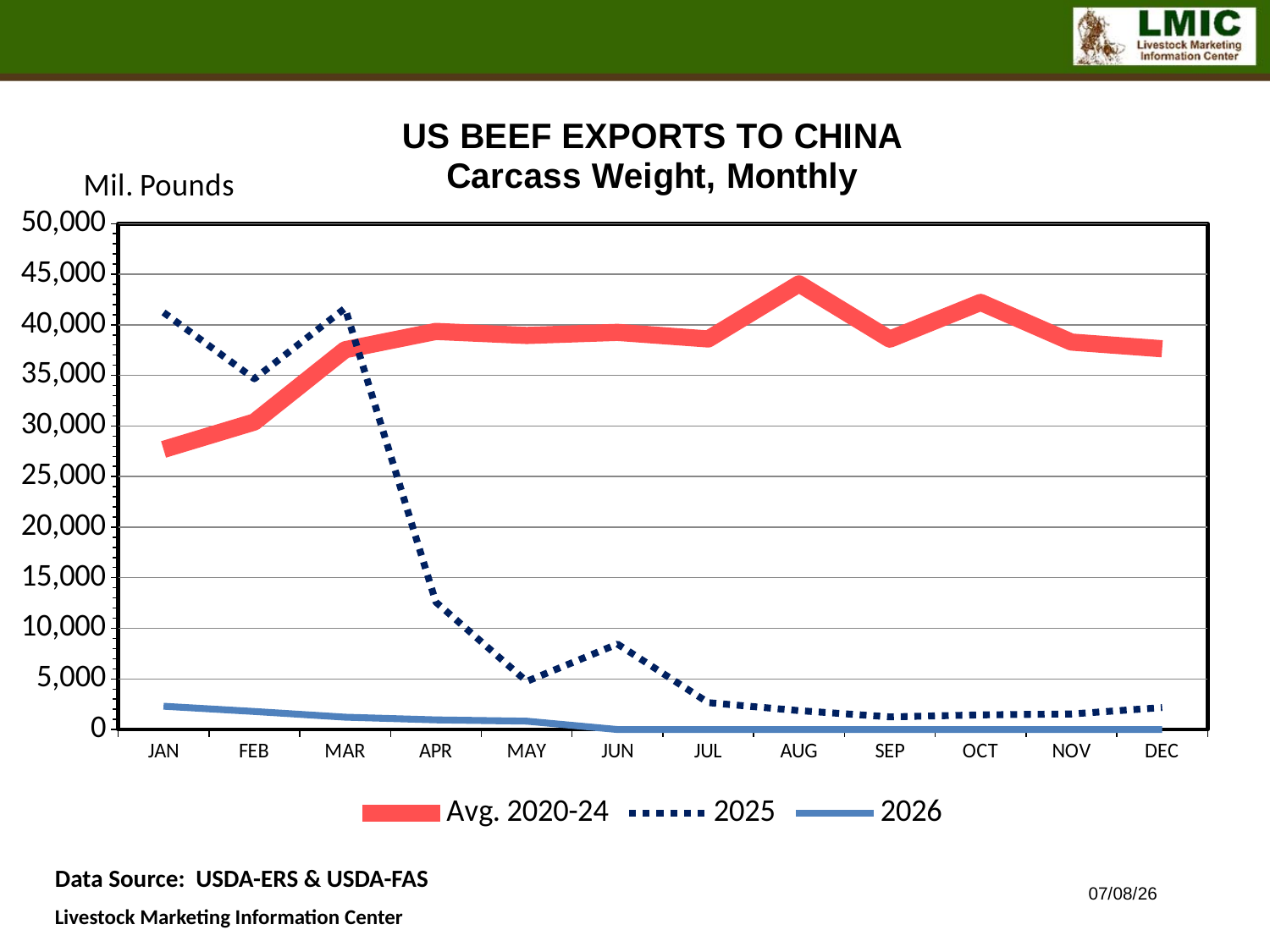
What unit is shown on the y axis label? Mil. Pounds In JAN, which series has the higher value, Avg. 2020-24 or 2025? 2025 What kind of chart is shown on the slide? Line chart Is the Avg. 2020-24 value for AUG greater or less than 40,000? greater How many series does the legend list? 3 Is the Avg. 2020-24 value for JAN greater or less than 30,000? less How many months are shown along the x axis? 12 Is the 2025 value for APR greater or less than 15,000? less Does the 2025 series rise or fall from MAR to JUL? Fall In which month is the Avg. 2020-24 series at its lowest? JAN In which month is the Avg. 2020-24 series at its highest? AUG